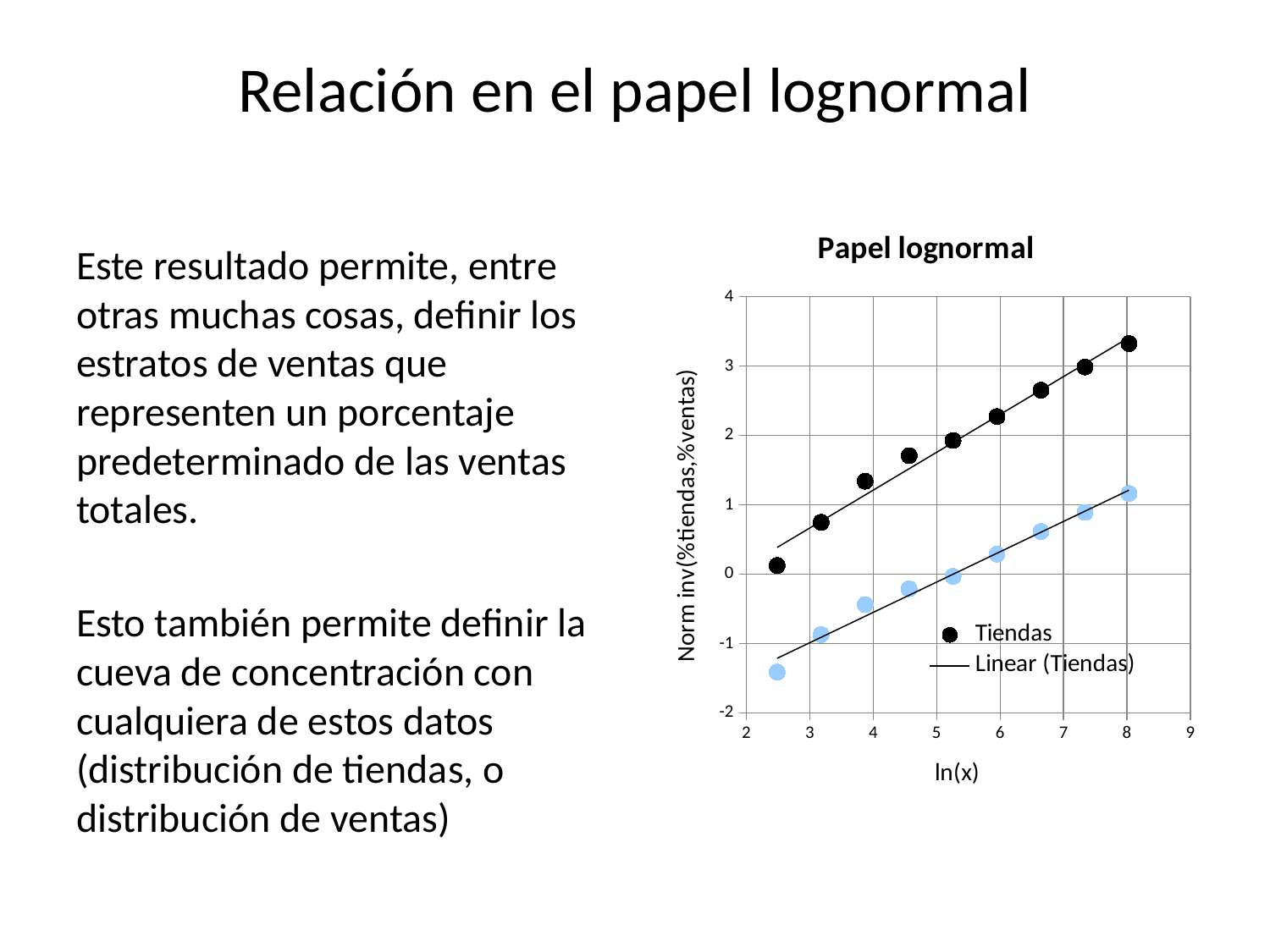
How many black 'Tiendas' points are plotted on the chart? 9 What is the title of the chart? Papel lognormal What is the label of the x axis of the chart? ln(x) Which black 'Tiendas' point has the highest value: the one at the smallest ln(x) or the one at the largest ln(x)? The one at the largest ln(x) Is the value of the leftmost light blue point (near ln(x) = 2.5) greater or less than -1? less Do the 'Tiendas' values rise or fall as ln(x) increases? Rise How many entries does the chart's legend list? 2 At ln(x) near 8, which series has the larger value: the black 'Tiendas' points or the light blue points? Black 'Tiendas' points What kind of chart is shown on the slide? Scatter chart Is the value of the leftmost black 'Tiendas' point (near ln(x) = 2.5) greater or less than 1? less Is the value of the rightmost black 'Tiendas' point (near ln(x) = 8) greater or less than 3? greater